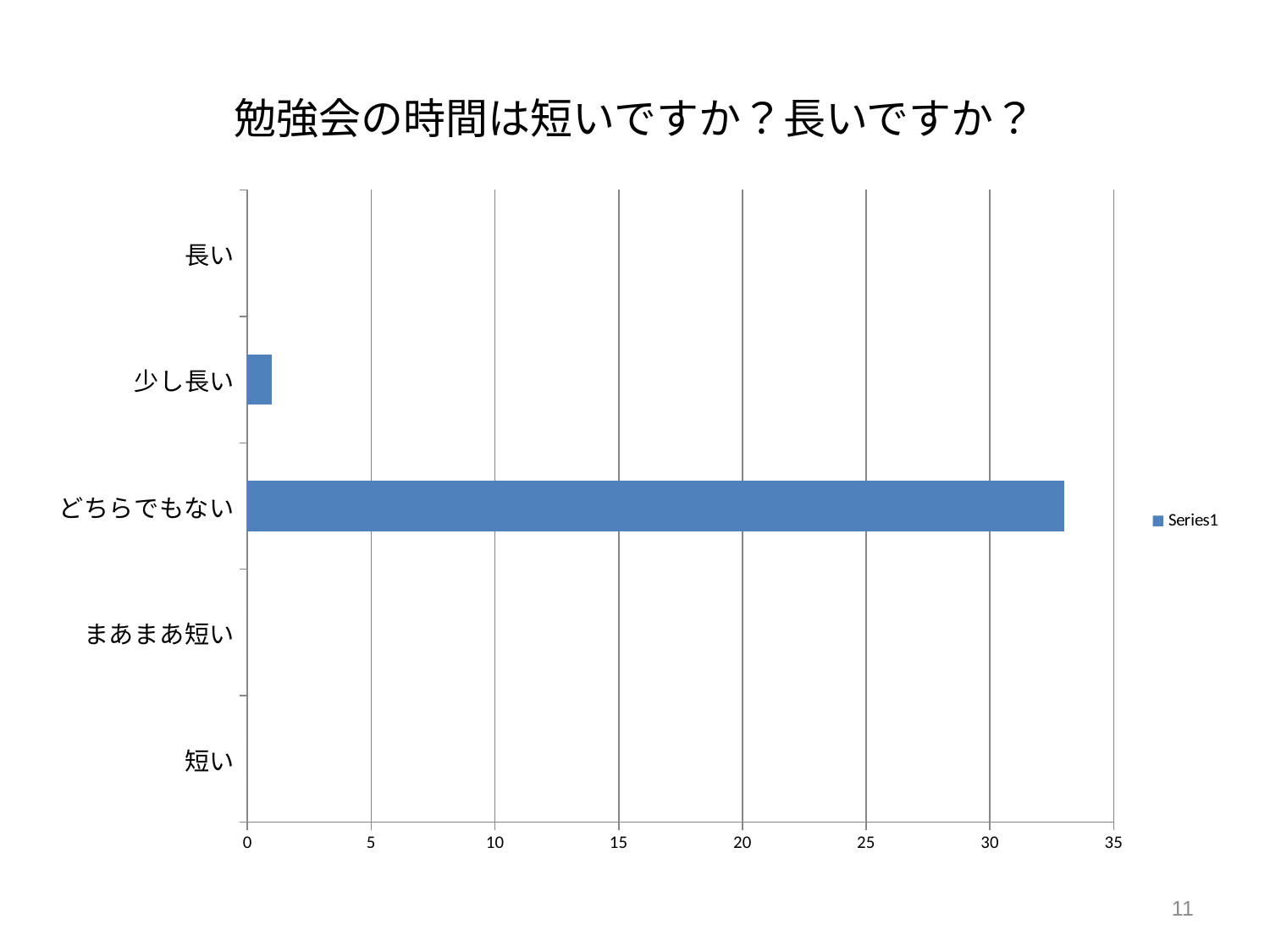
Is the value for 少し長い greater or less than 5? less What is the title of the chart? 勉強会の時間は短いですか？長いですか？ What is the name of the series shown in the legend? Series1 Is the value for どちらでもない greater or less than 30? greater Which has the larger value, どちらでもない or 少し長い? どちらでもない Which category has the longest bar? どちらでもない How many series does the legend list? 1 Is the value for どちらでもない greater or less than 35? less How many categories are shown on the vertical axis of the chart? 5 Which category has the second-longest bar? 少し長い What kind of chart is shown on the slide? bar chart